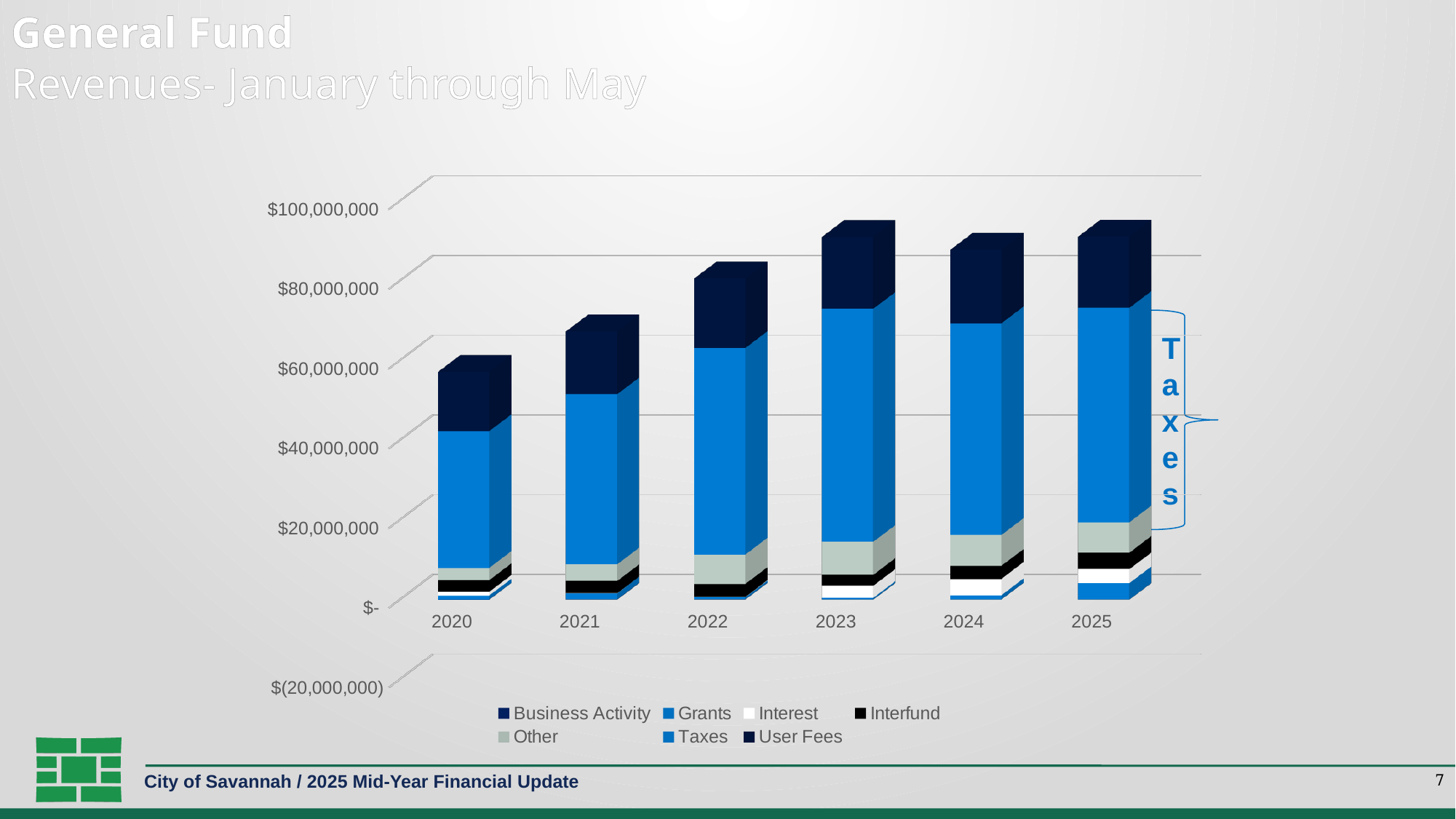
What kind of chart is shown on the slide? Stacked bar chart Do the total revenue bars generally rise or fall from 2020 to 2023? rise How many series does the chart's legend list? 7 Which year has the larger total revenue bar, 2022 or 2024? 2024 Which year has the lowest total revenue bar? 2020 Is the total revenue bar for 2025 greater or less than $80,000,000? greater Is the total revenue bar for 2021 greater or less than $80,000,000? less Is the total revenue bar for 2022 greater or less than $60,000,000? greater Which series is highlighted by the bracket annotation to the right of the 2025 bar? Taxes Which year has the larger total revenue bar, 2020 or 2021? 2021 How many years are shown along the x axis of the chart? 6